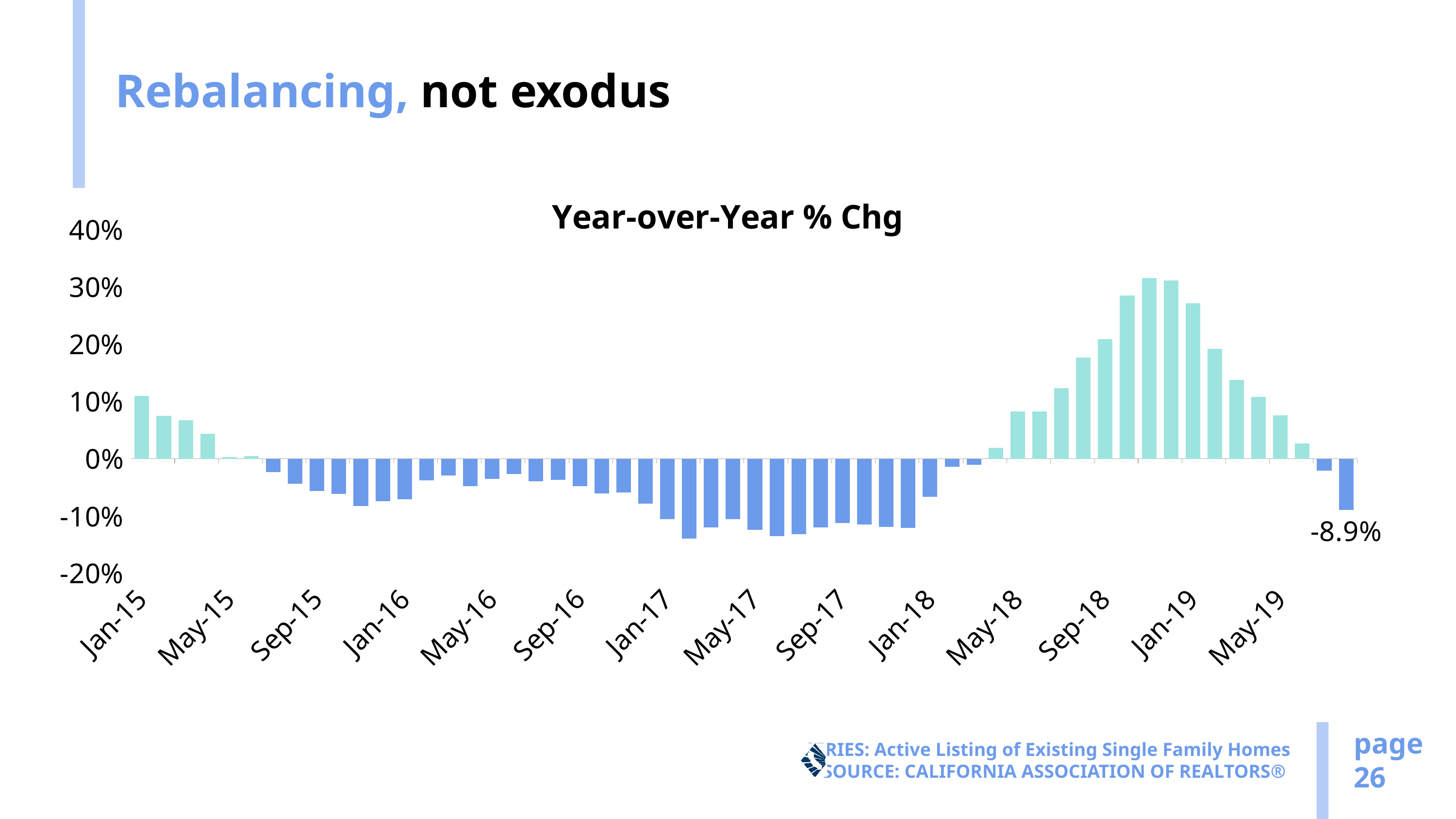
Do the values rise or fall from Sep-18 to Jan-19? rise What is the title of the chart? Year-over-Year % Chg Which is larger, the value for Sep-17 or the value for Sep-18? Sep-18 What colour are the bars with negative values? blue Which is larger, the value for Jan-15 or the value for Jan-16? Jan-15 Is the value for Jan-19 greater or less than 20%? greater What value is labelled on the last (most recent) bar of the chart? -8.9% Is the value for Sep-15 greater or less than 0%? less What kind of chart is shown on the slide? bar chart Is the value for Sep-18 greater or less than 10%? greater Do the values rise or fall from Jan-19 to May-19? fall